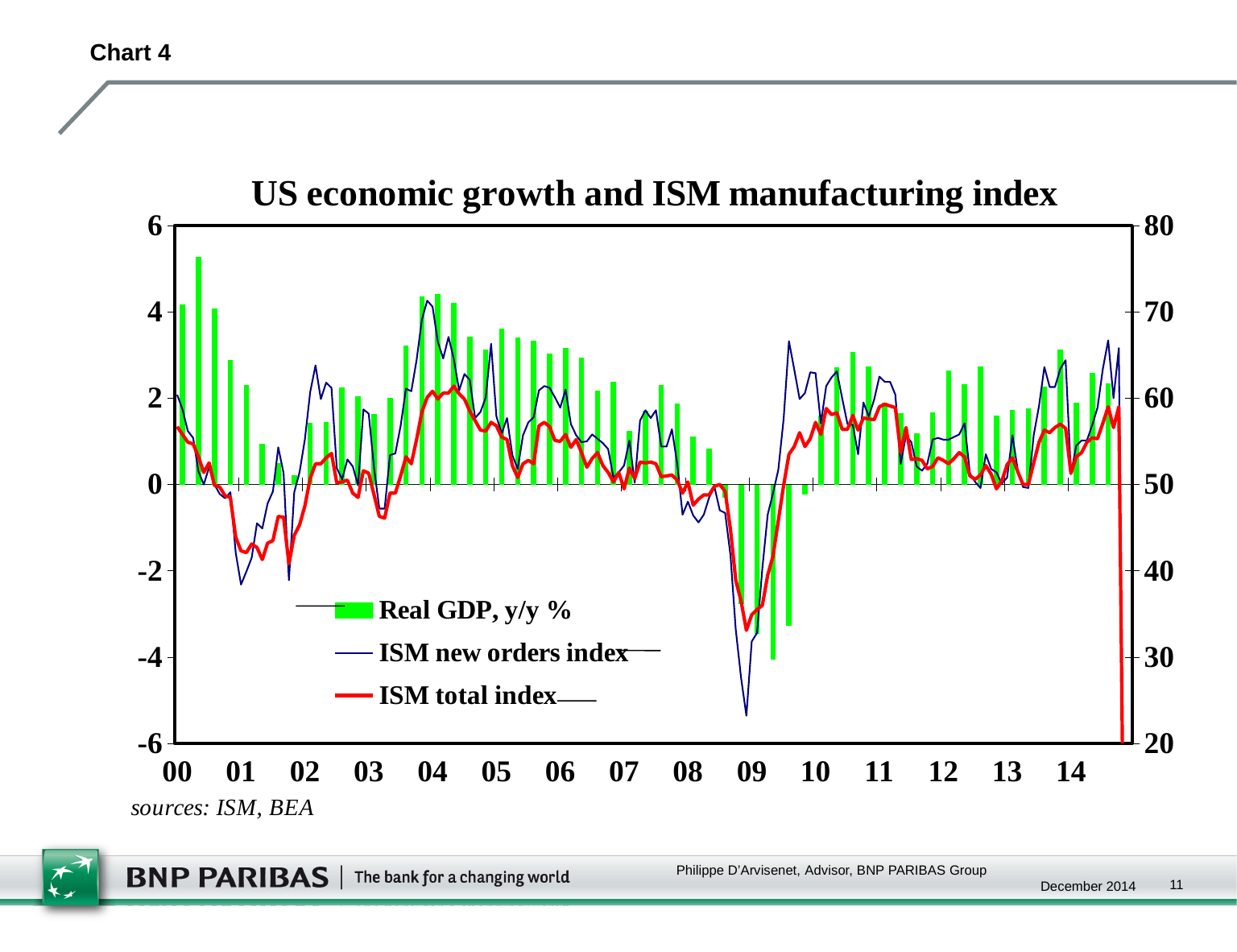
Is the lowest Real GDP, y/y % bar, in 2009, greater or less than -2 on the left axis? less How many year labels are shown on the x axis? 15 What is the maximum value shown on the right-hand axis? 80 Is the lowest point of the ISM total index, around the start of 2009, greater or less than 40 on the right axis? less Which series is drawn as green bars? Real GDP, y/y % Do the Real GDP, y/y % bars rise or fall from 2004 to 2006? fall What is the title of the chart? US economic growth and ISM manufacturing index Is the tallest Real GDP, y/y % bar, in 2000, greater or less than 4 on the left axis? greater Does the ISM new orders index rise or fall between 2008 and the start of 2009? fall What kind of chart is this? Combined bar and line chart How many series does the chart's legend list? 3